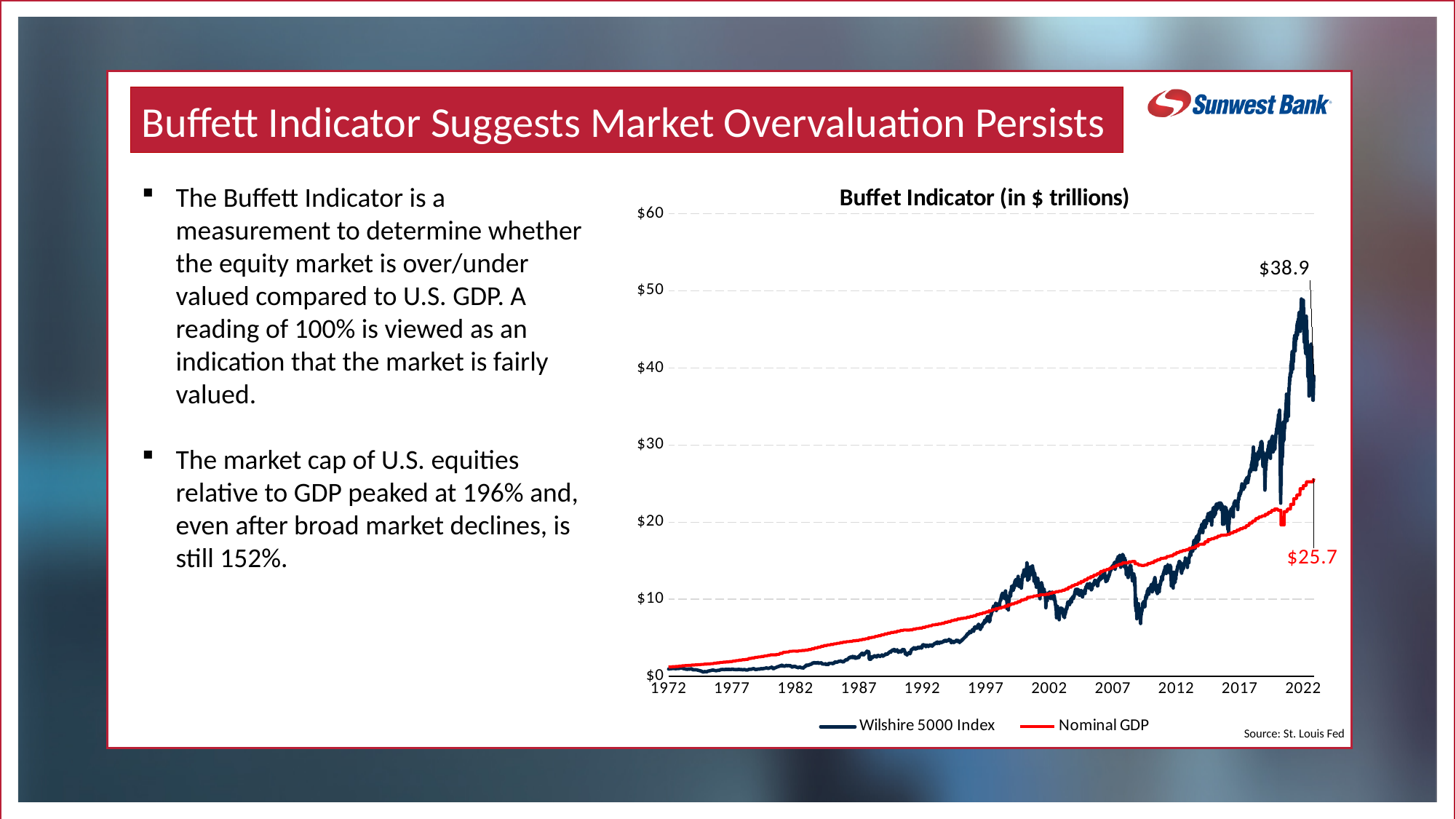
Which series reaches the highest value anywhere on the chart? Wilshire 5000 Index What colour is the Nominal GDP line in the chart? Red Is the value of Nominal GDP in 2002 greater or less than $20? less What is the labelled latest value of Nominal GDP on the chart? $25.7 Does the Nominal GDP line generally rise or fall from 1972 to 2022? Rise What is the difference between the labelled latest values of the Wilshire 5000 Index ($38.9) and Nominal GDP ($25.7)? $13.2 What is the title of the chart? Buffet Indicator (in $ trillions) At the end of the chart, which series has the larger labelled value, Wilshire 5000 Index or Nominal GDP? Wilshire 5000 Index What kind of chart is shown on the slide? Line chart Is the value of the Wilshire 5000 Index in 1992 greater or less than $10? less How many series does the chart's legend list? 2 What is the labelled latest value of the Wilshire 5000 Index on the chart? $38.9